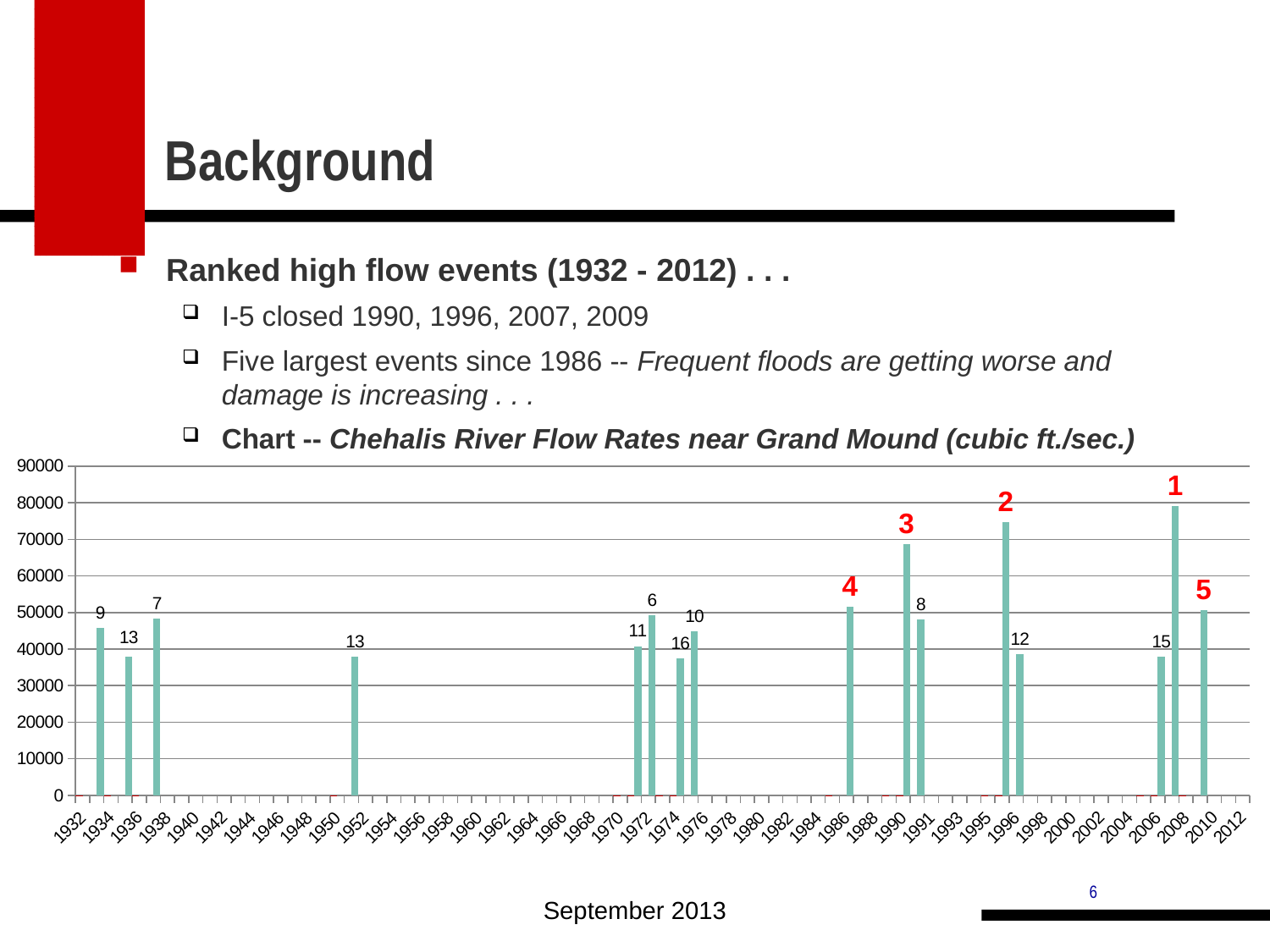
What rank label is printed above the bar for 1986? 4 What is the title of the chart according to the slide? Chehalis River Flow Rates near Grand Mound (cubic ft./sec.) Which year has the highest flow rate in the chart? 2007 How many high flow events (bars) are plotted in the chart? 16 Is the flow rate for 2007 greater or less than 70000? greater Is the flow rate for 1951 greater or less than 40000? less What rank label is printed above the bar for 1990? 3 Which year has the larger flow rate, 2007 or 1996? 2007 Which year has the larger flow rate, 1990 or 1986? 1990 What rank label is printed above the bar for 2007? 1 What kind of chart is shown on the slide? bar chart